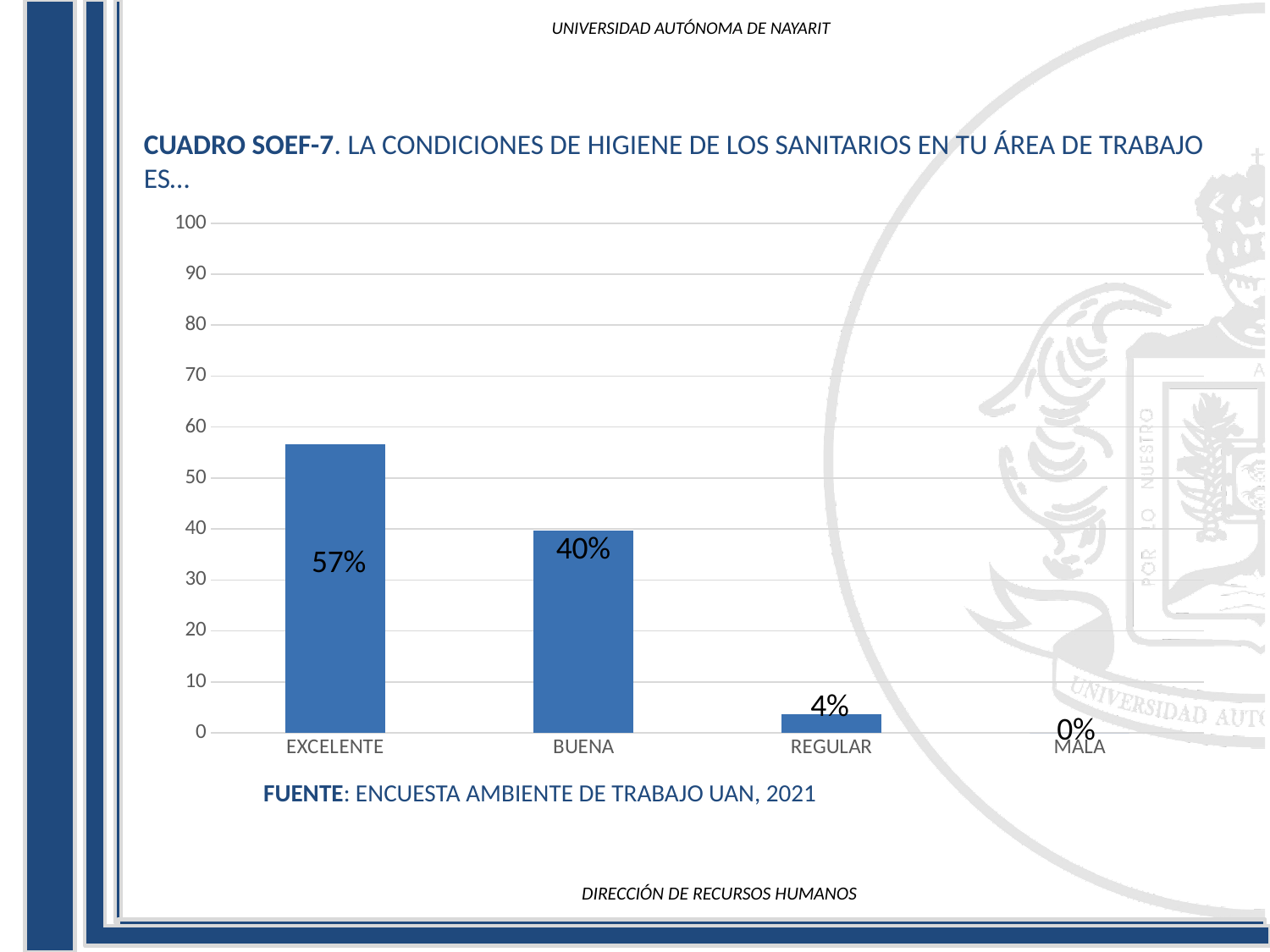
What is the value for REGULAR? 4% What is the value for BUENA? 40% Which category has the lowest value? MALA What is the difference between the values for EXCELENTE and BUENA? 17% Which is larger, the value for BUENA or the value for REGULAR? BUENA Is the value for EXCELENTE greater or less than 50? greater How many categories are shown on the x axis? 4 Which category has the highest value? EXCELENTE What is the value for MALA? 0% What source is cited below the chart? ENCUESTA AMBIENTE DE TRABAJO UAN, 2021 What is the value for EXCELENTE? 57% What kind of chart is shown on the slide? bar chart